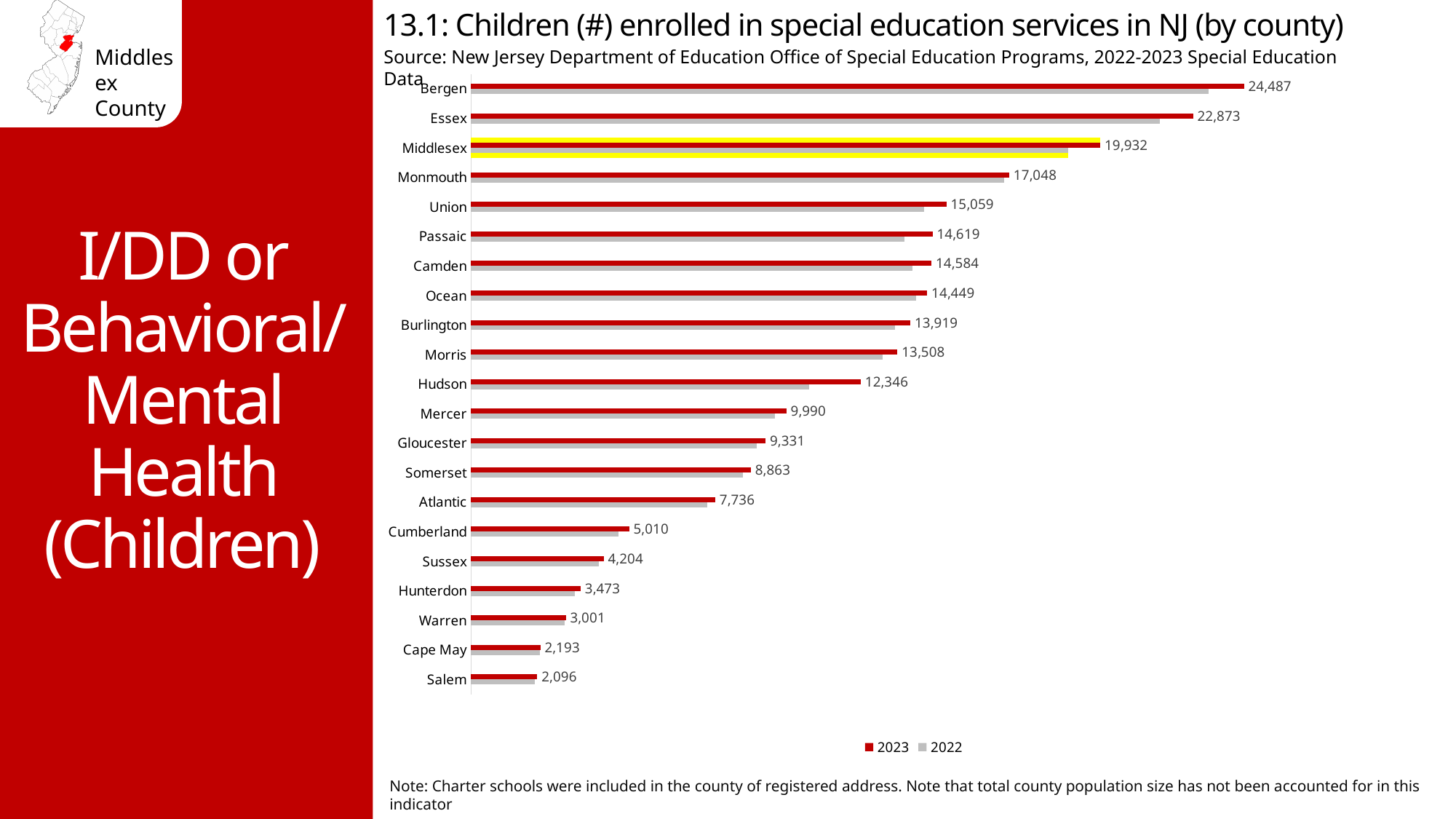
What is the difference between the 2023 values for Bergen and Essex? 1,614 Which county's bars are highlighted in yellow? Middlesex What is the 2023 value for Middlesex? 19,932 What is the 2023 value for Hudson? 12,346 How many series does the legend list? 2 Which county has the lowest 2023 value? Salem What is the difference between the 2023 values for Middlesex and Monmouth? 2,884 How many counties are shown in the chart? 21 Which has a larger 2023 value, Mercer or Gloucester? Mercer What kind of chart is shown on the slide? Bar chart What is the 2023 value for Cumberland? 5,010 Which county has the highest 2023 value? Bergen